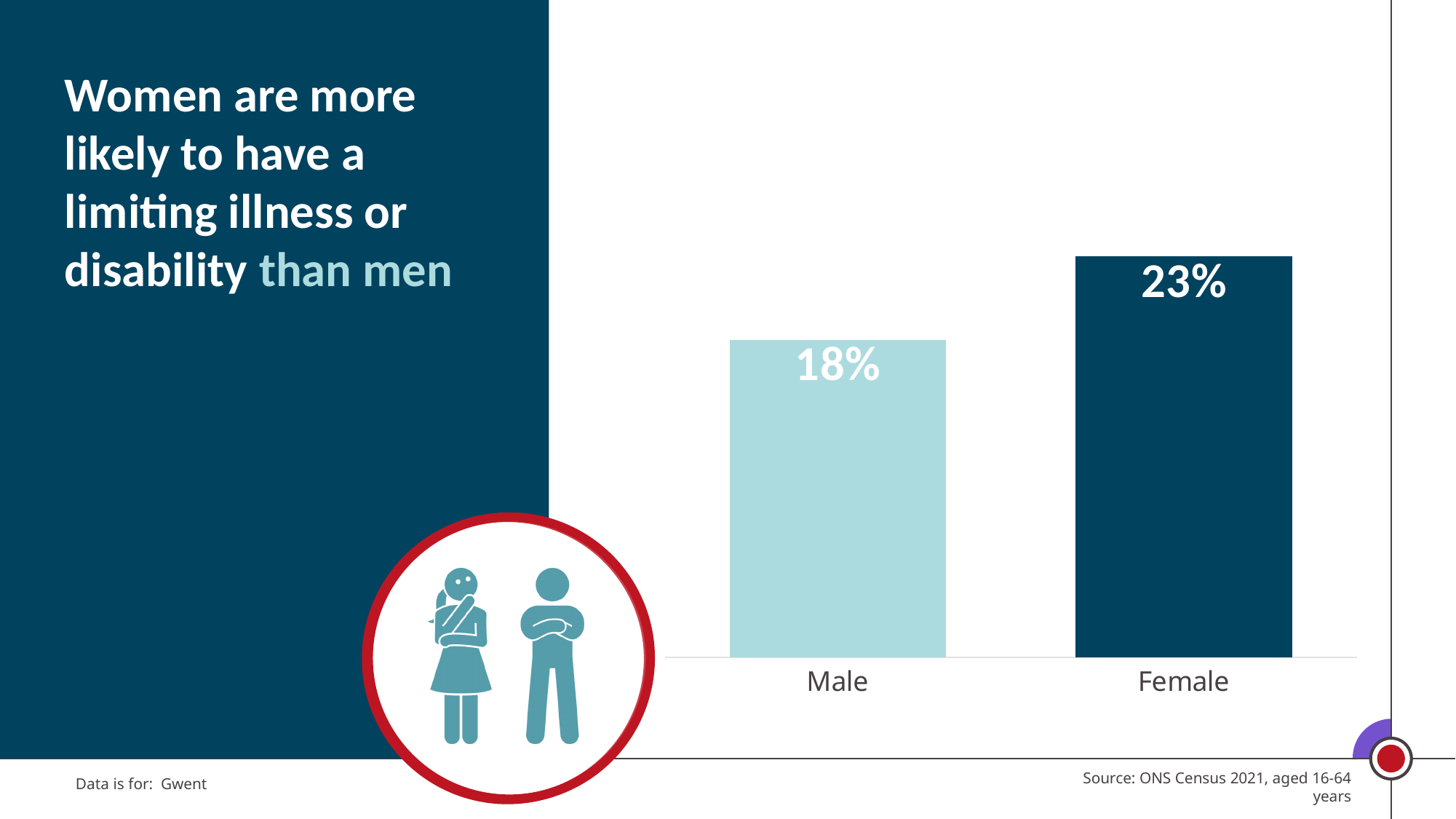
Is the value for Male larger or smaller than the value for Female? smaller What percentage of males have a limiting illness or disability? 18% Which area does the data on the slide cover? Gwent What is the difference in percentage points between the Female and Male values? 5 percentage points What percentage of females have a limiting illness or disability? 23% Do the values rise or fall from Male to Female along the x axis? rise What kind of chart is shown on the slide? bar chart Which category has the lowest value? Male How many categories are shown on the chart? 2 Which category has the higher value, Male or Female? Female What is the source of the data shown on the chart? ONS Census 2021, aged 16-64 years